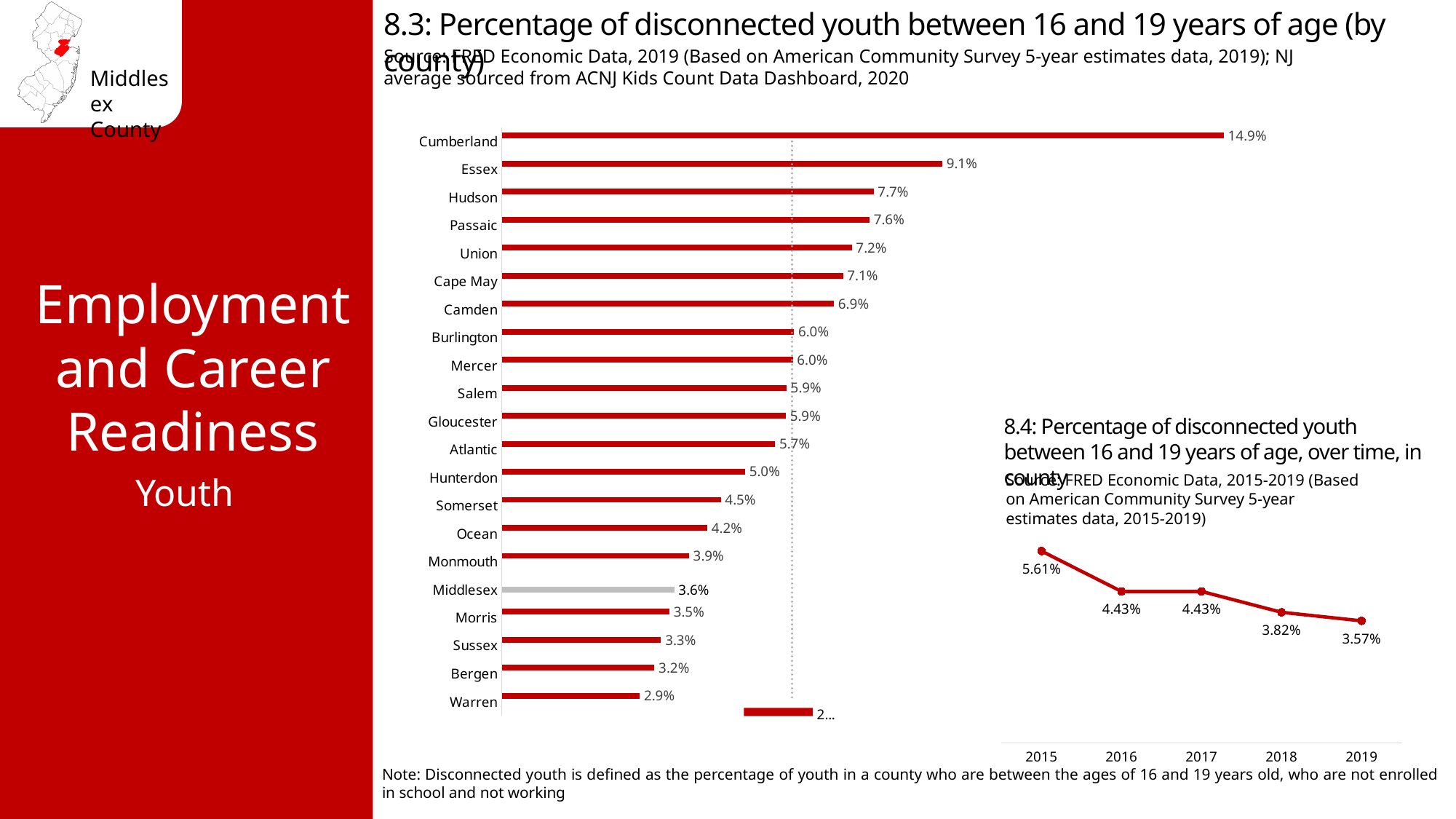
In the chart 8.4 (percentage of disconnected youth over time), what is the value for 2019? 3.57% In the chart 8.4 (percentage of disconnected youth over time), what is the value for 2015? 5.61% How many years are plotted in chart 8.4 (percentage of disconnected youth over time)? 5 In the chart 8.3 (percentage of disconnected youth by county), what is the value for Middlesex? 3.6% In the chart 8.3 (percentage of disconnected youth by county), which is larger, the value for Somerset or the value for Ocean? Somerset In the chart 8.3 (percentage of disconnected youth by county), what is the value for Cumberland? 14.9% In the chart 8.3 (percentage of disconnected youth by county), which county has the lowest percentage? Warren In the chart 8.3 (percentage of disconnected youth by county), what is the difference between Essex and Hudson? 1.4% What kind of chart is chart 8.4 (percentage of disconnected youth over time)? Line chart What kind of chart is chart 8.3 (percentage of disconnected youth by county)? Bar chart In the chart 8.3 (percentage of disconnected youth by county), which county has the highest percentage? Cumberland In the chart 8.4 (percentage of disconnected youth over time), do the values rise or fall from 2015 to 2019? Fall